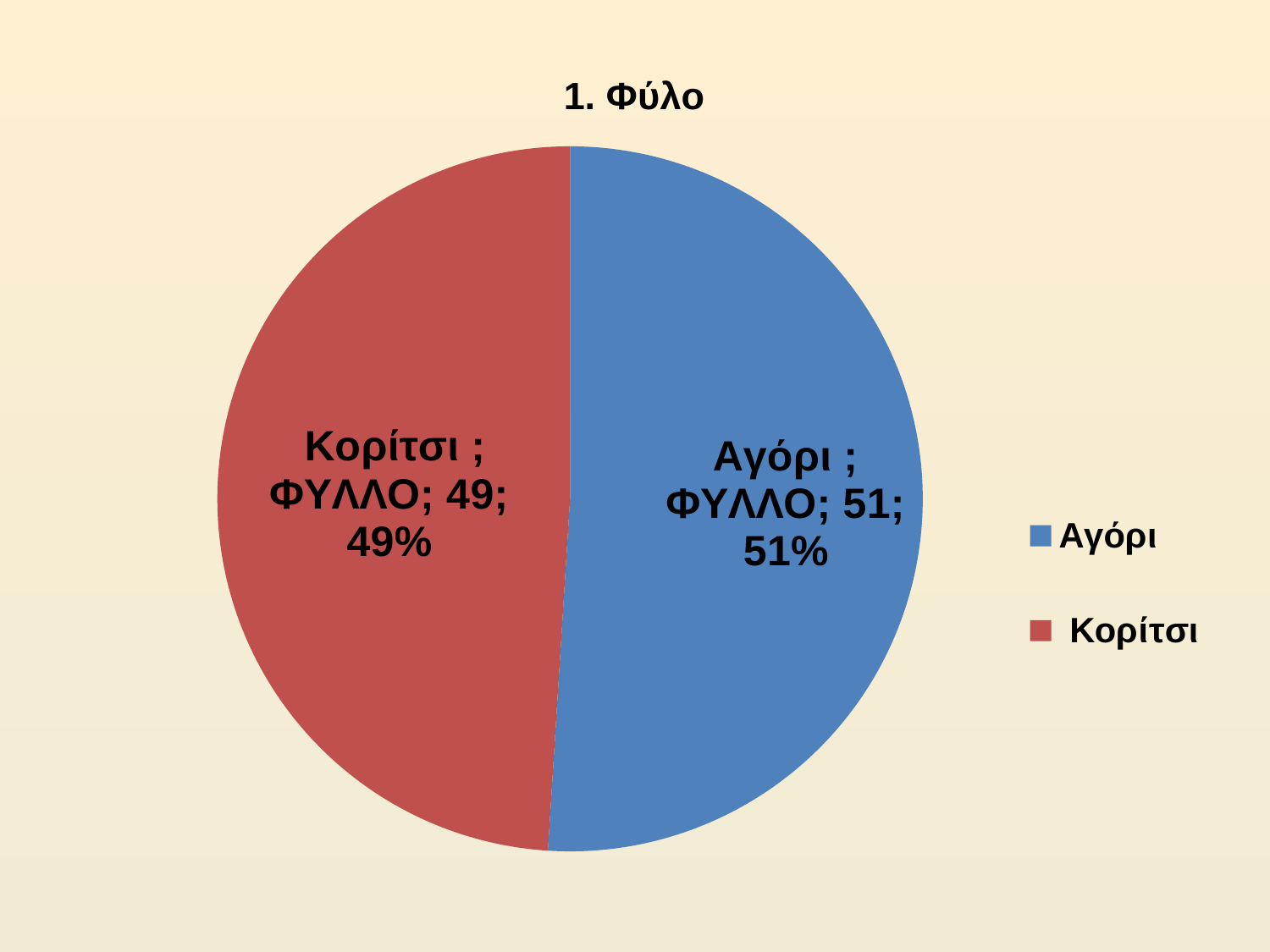
What share of the pie does Αγόρι represent? 51% Which category has the smallest slice? Κορίτσι What is the value for Αγόρι? 51 Which category has the largest slice? Αγόρι What is the title of the chart? 1. Φύλο What kind of chart is shown on the slide? pie chart How many slices does the pie chart have? 2 Which colour represents Κορίτσι in the chart? red How many entries does the legend list? 2 What is the value for Κορίτσι? 49 What is the difference between the values for Αγόρι and Κορίτσι? 2 What share of the pie does Κορίτσι represent? 49%